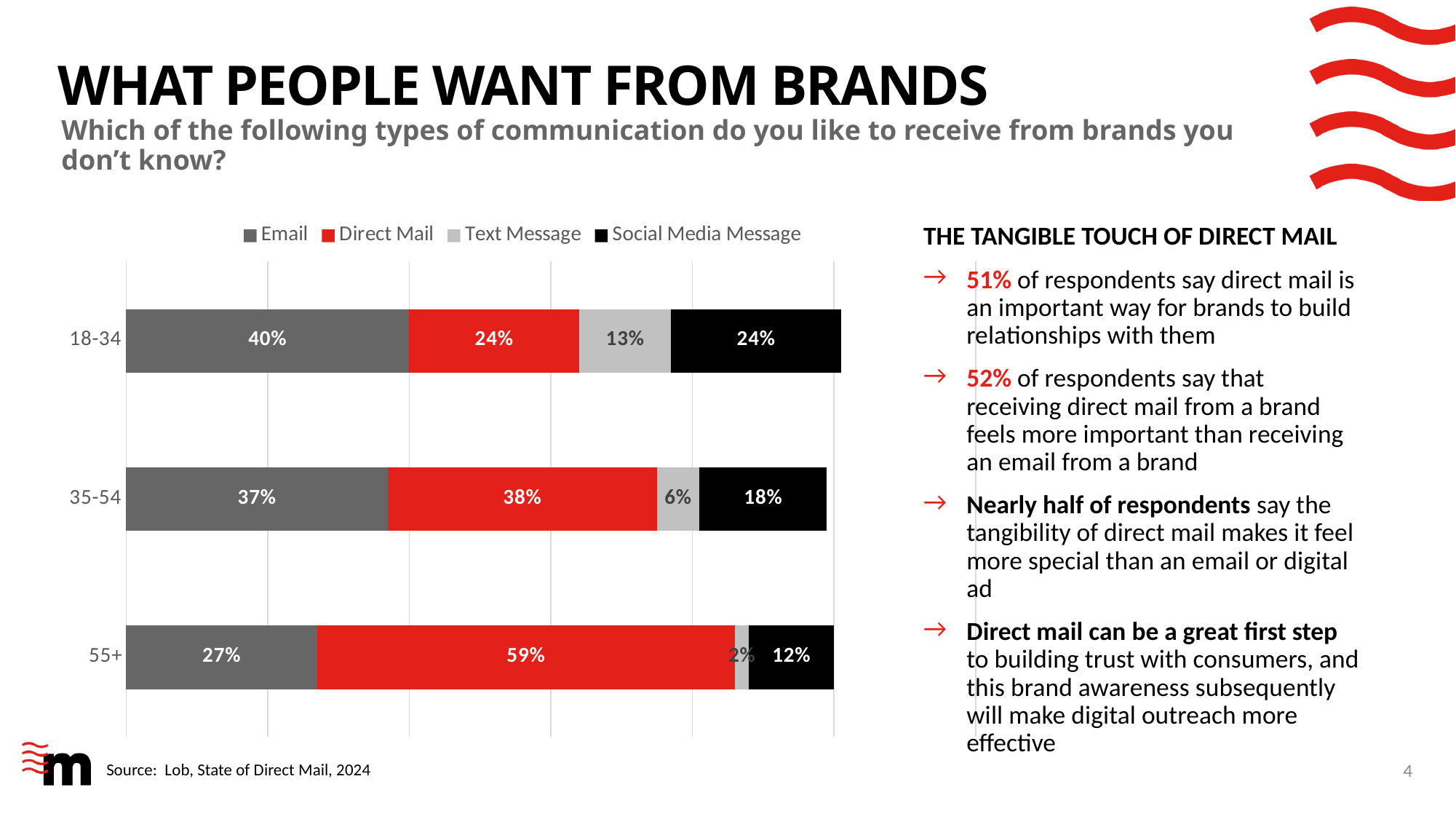
Which age group has the lowest Text Message value? 55+ Which age group has the highest Direct Mail value? 55+ How many series does the legend list? 4 Does the Email value rise or fall as the age group gets older, from 18-34 to 55+? Fall What is the Direct Mail value for the 55+ age group? 59% What is the Text Message value for the 35-54 age group? 6% What is the Social Media Message value for the 18-34 age group? 24% How many age groups are shown in the chart? 3 What percentage of 18-34 year olds like to receive Email from brands they don't know? 40% How much higher is the Direct Mail value for 55+ than for 18-34? 35 percentage points For the 35-54 age group, which is larger: Email or Direct Mail? Direct Mail What kind of chart is shown on the slide? Stacked bar chart